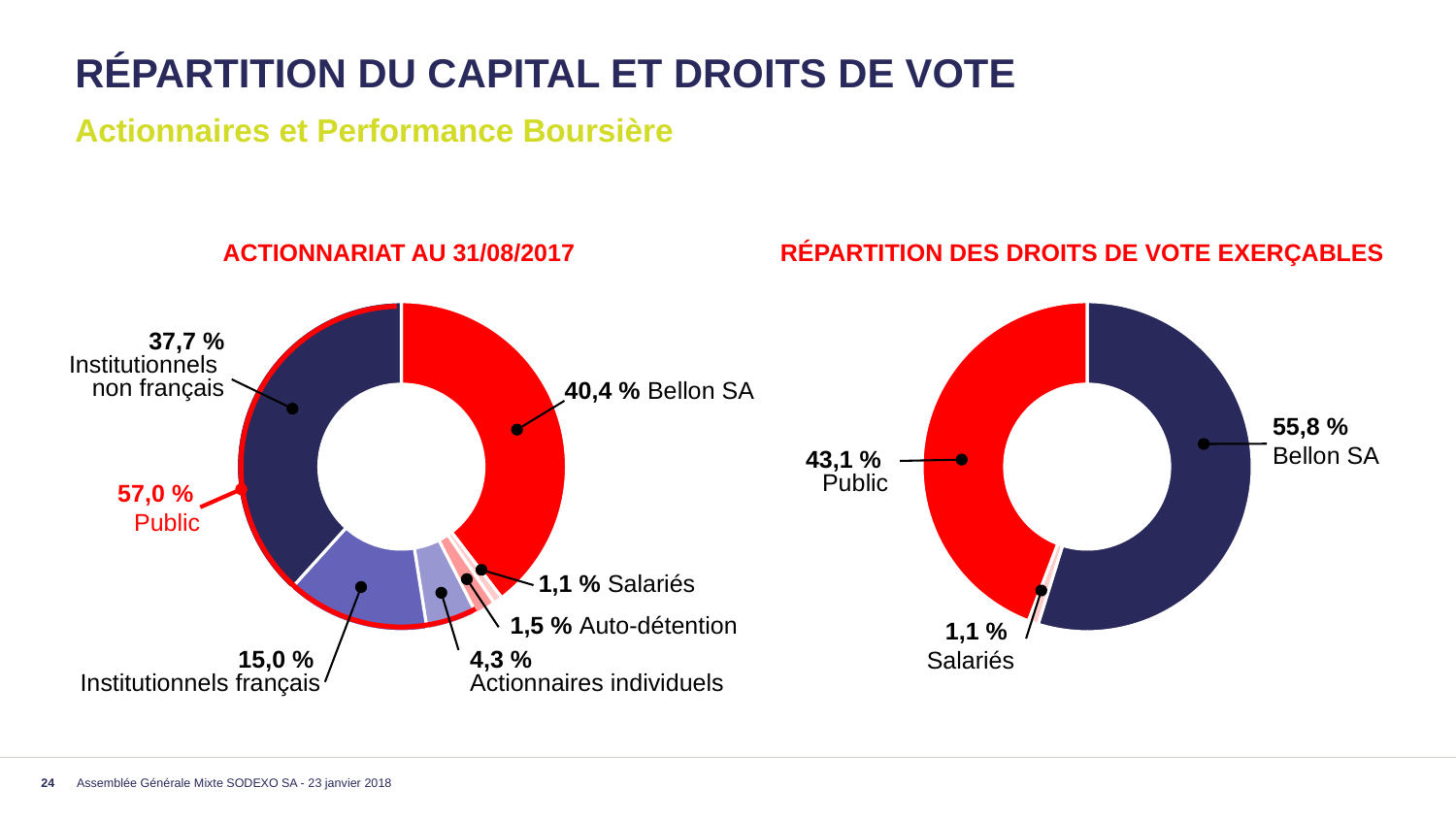
In the chart titled ACTIONNARIAT AU 31/08/2017, what share is held by Institutionnels français? 15,0 % In the chart titled ACTIONNARIAT AU 31/08/2017, what share is held by Bellon SA? 40,4 % What kind of chart is the chart titled RÉPARTITION DES DROITS DE VOTE EXERÇABLES? Donut (pie) chart In the chart titled ACTIONNARIAT AU 31/08/2017, which category has the smallest share? Salariés In the chart titled RÉPARTITION DES DROITS DE VOTE EXERÇABLES, which is larger: Bellon SA or Public? Bellon SA In the chart titled ACTIONNARIAT AU 31/08/2017, what share is held by Actionnaires individuels? 4,3 % In the chart titled RÉPARTITION DES DROITS DE VOTE EXERÇABLES, what share of voting rights does the Public hold? 43,1 % In the chart titled ACTIONNARIAT AU 31/08/2017, what total share is labelled as Public? 57,0 % In the chart titled ACTIONNARIAT AU 31/08/2017, what share is Auto-détention? 1,5 % In the chart titled ACTIONNARIAT AU 31/08/2017, what is the difference between the Bellon SA share and the Institutionnels non français share? 2,7 % In the chart titled RÉPARTITION DES DROITS DE VOTE EXERÇABLES, what share of voting rights does Bellon SA hold? 55,8 % In the chart titled ACTIONNARIAT AU 31/08/2017, what share is held by Institutionnels non français? 37,7 %